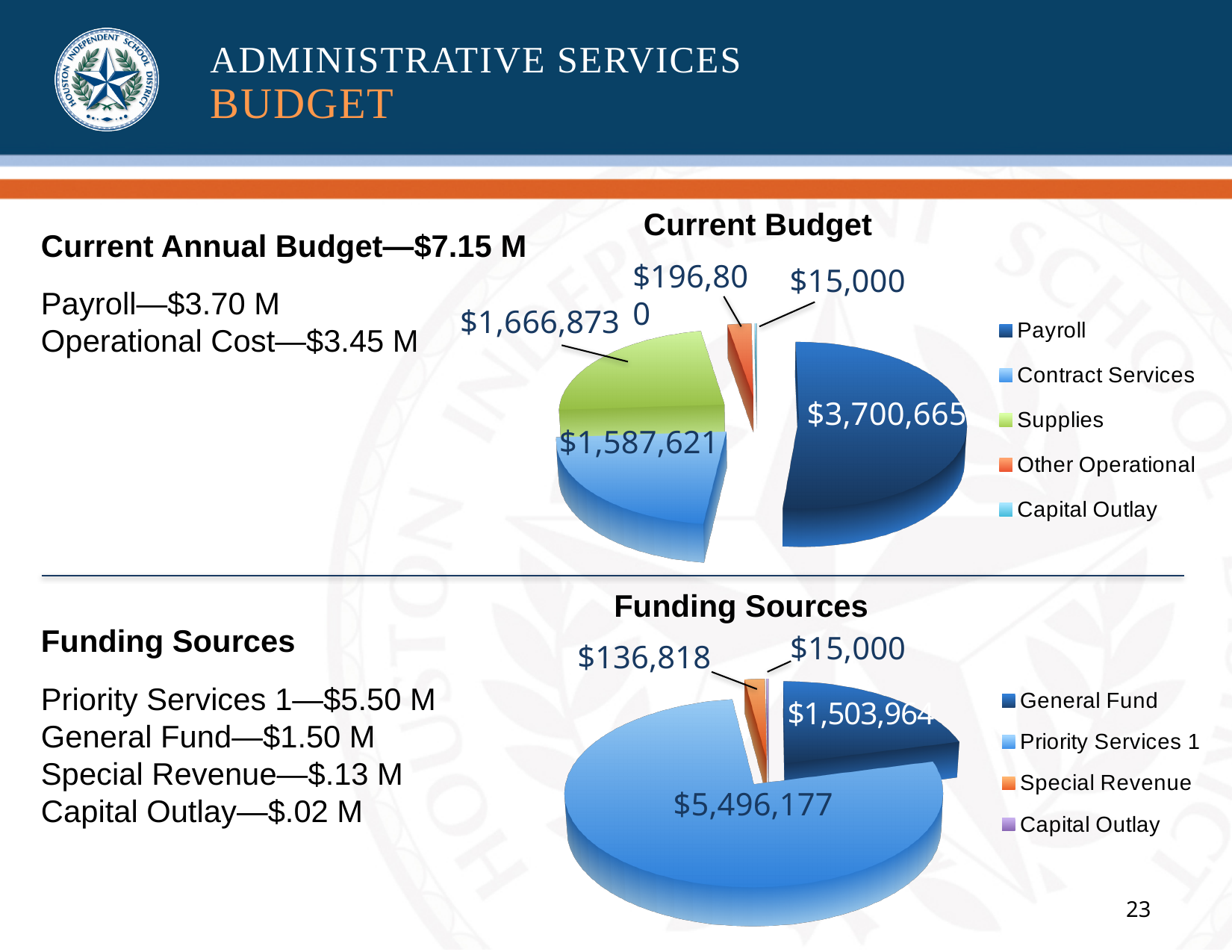
In the Current Budget chart, what is the value for Contract Services? $1,587,621 In the Funding Sources chart, what is the difference between Priority Services 1 and General Fund? $3,992,213 In the Current Budget chart, what is the value for Supplies? $1,666,873 In the Current Budget chart, which category has the smallest slice? Capital Outlay In the Current Budget chart, how many categories does the legend list? 5 In the Funding Sources chart, what is the value for Priority Services 1? $5,496,177 In the Funding Sources chart, which is larger, General Fund or Priority Services 1? Priority Services 1 In the Current Budget chart, what is the difference between Supplies and Contract Services? $79,252 In the Current Budget chart, which category has the largest slice? Payroll In the Funding Sources chart, what is the value for Special Revenue? $136,818 What type of chart is the Funding Sources chart? Pie chart In the Current Budget chart, what is the value for Payroll? $3,700,665